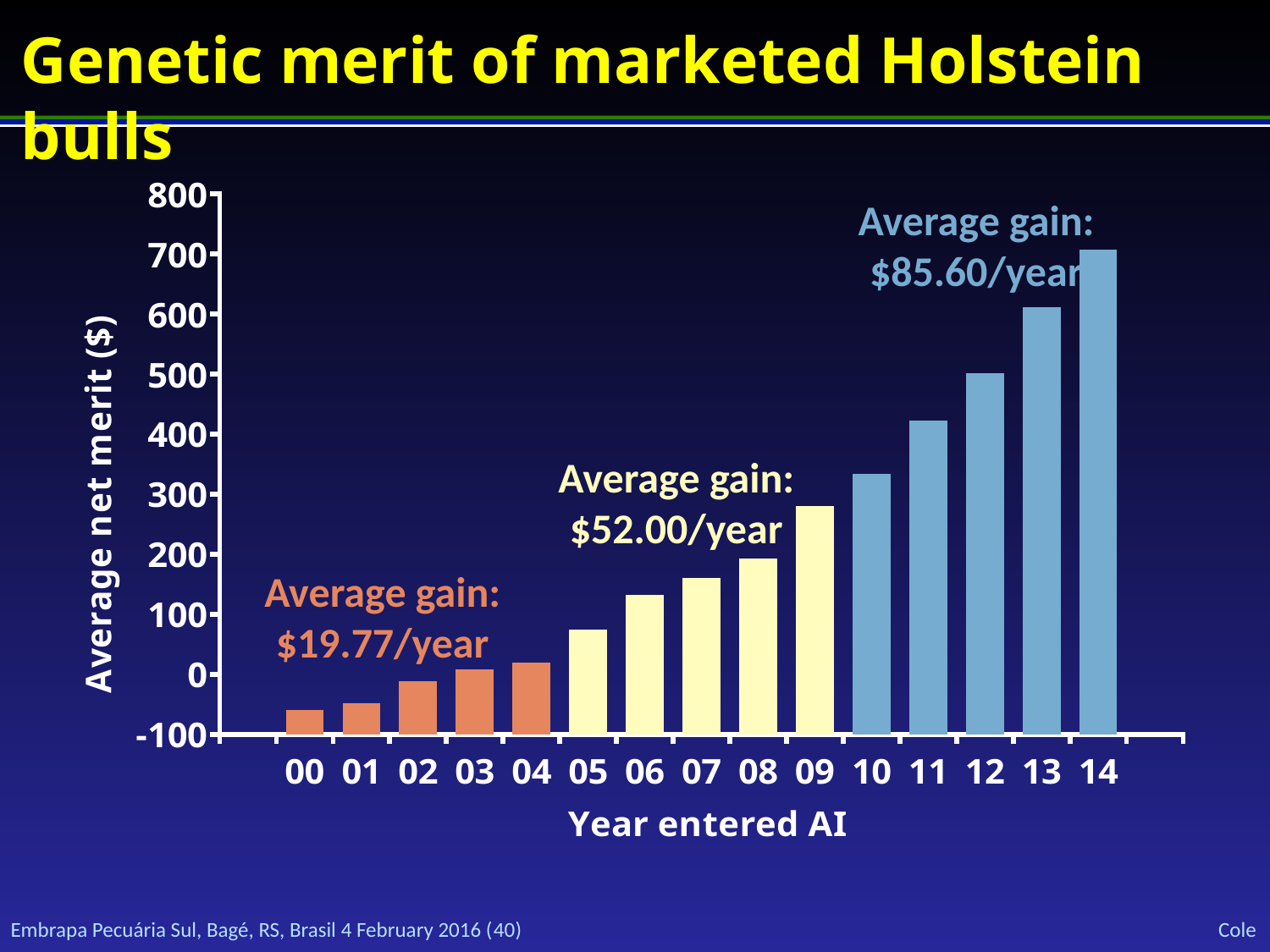
Is the average net merit for year 13 greater or less than 500? greater How many years (bars) are plotted on the x axis? 15 Which year entered AI has the highest average net merit? 14 What is the label of the y axis? Average net merit ($) Which year entered AI has the lowest average net merit? 00 Is the average net merit for year 00 greater or less than 0? less Is the average net merit for year 06 greater or less than 100? greater What average gain per year is stated for the blue bars (years 10 to 14)? $85.60/year Do the average net merit values rise or fall from year 00 to year 14? rise What kind of chart is shown on the slide? bar chart Which year has a higher average net merit, 09 or 10? 10